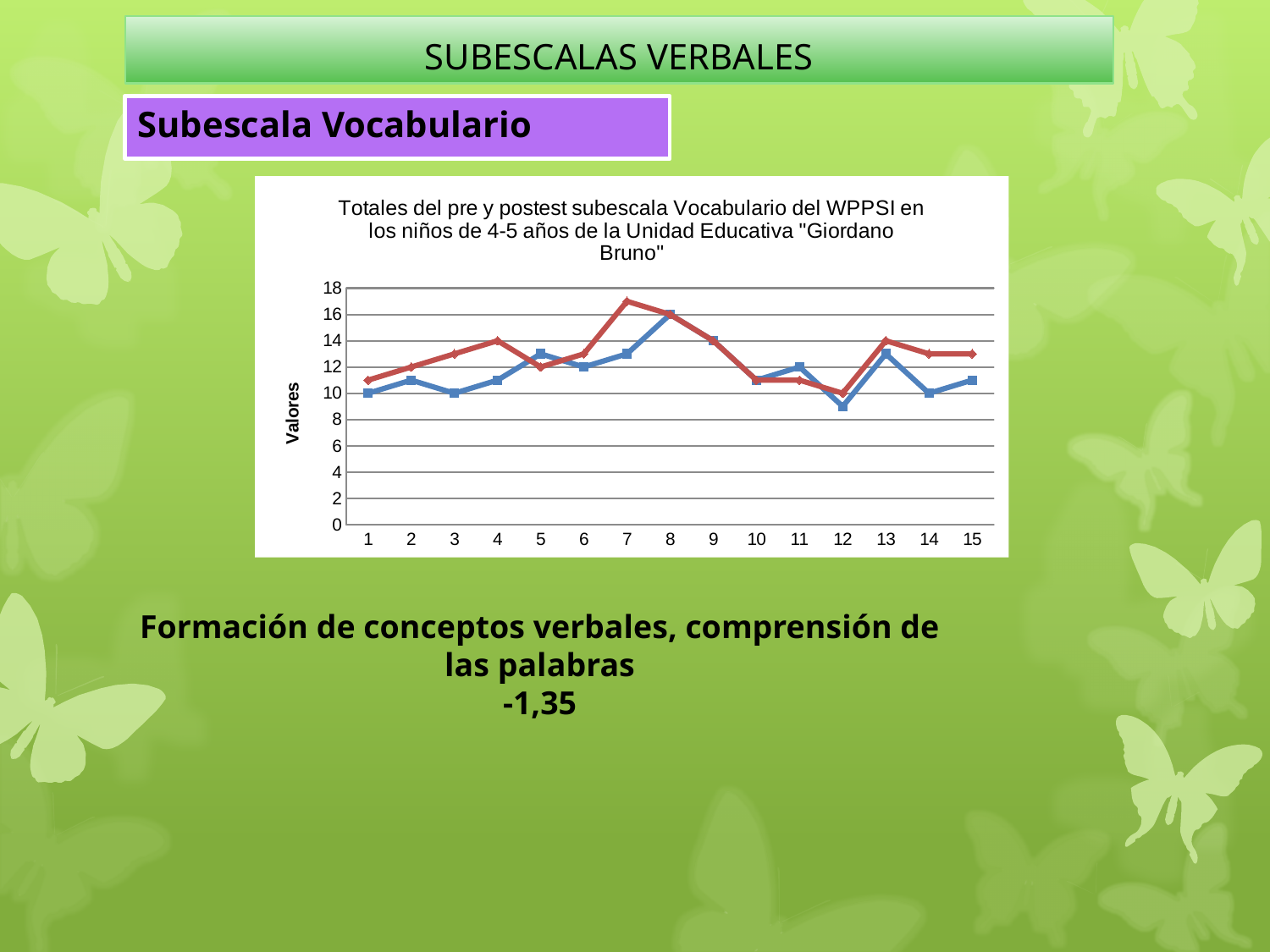
What is the value of the red line at x = 8? 16 How many points are plotted along the x axis of the chart? 15 What is the label on the y axis of the chart? Valores At which x value does the red line reach its highest point? 7 Is the value of the blue line at x = 12 greater or less than 10? less At x = 4, which line has the larger value, the red line or the blue line? red line What is the value of the red line at x = 12? 10 Is the value of the red line at x = 7 greater or less than 16? greater What is the value of the blue line at x = 1? 10 At which x value does the blue line reach its lowest point? 12 What is the difference between the red line's value at x = 8 and its value at x = 12? 6 What kind of chart is shown on the slide? line chart